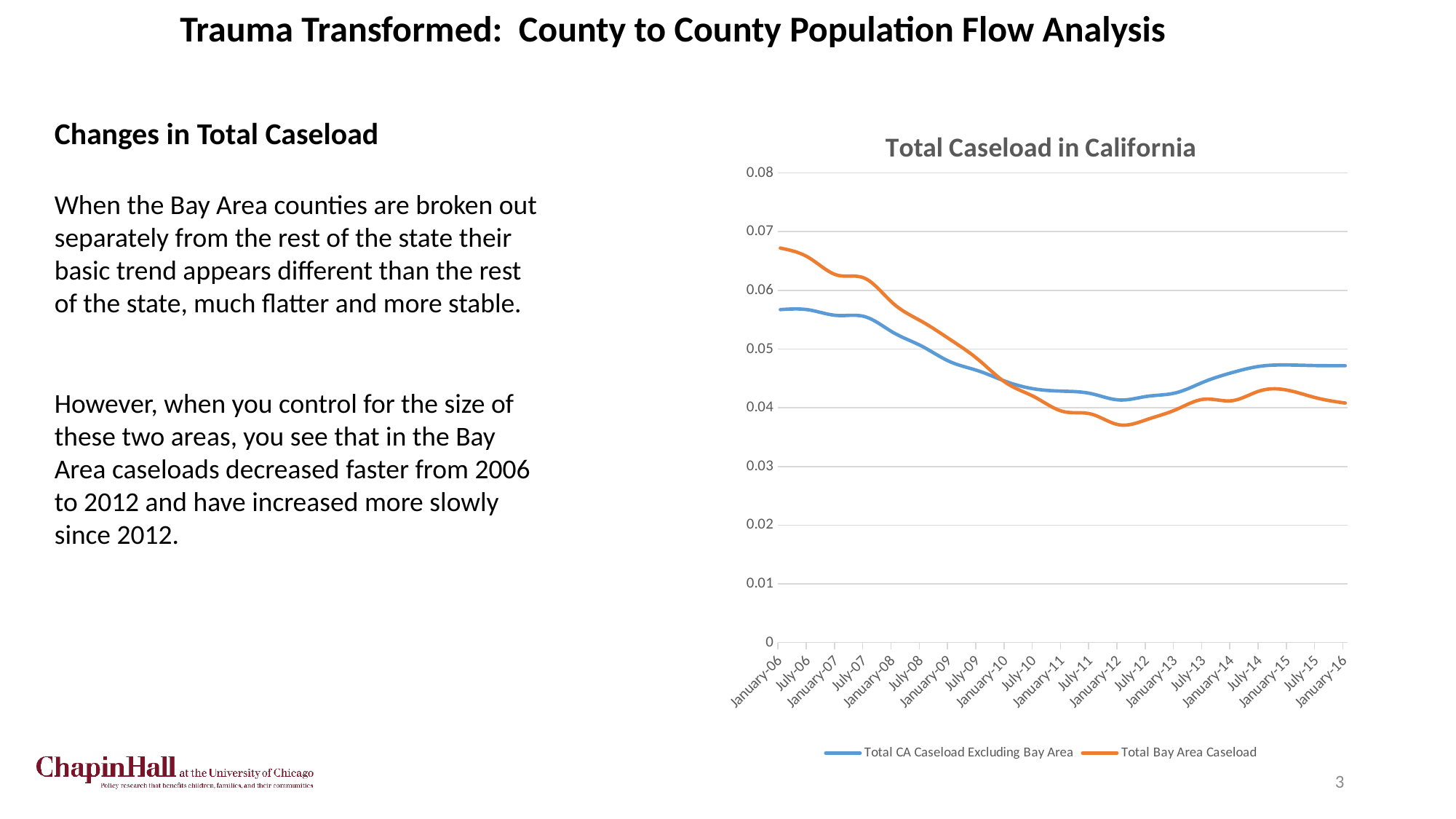
How many series does the legend list? 2 Is the Total CA Caseload Excluding Bay Area value at January-06 greater or less than 0.06? less Is the Total CA Caseload Excluding Bay Area value at January-16 greater or less than 0.04? greater Is the Total Bay Area Caseload value at January-12 greater or less than 0.04? less At January-16, which series has the higher value: Total CA Caseload Excluding Bay Area or Total Bay Area Caseload? Total CA Caseload Excluding Bay Area How many dates are labelled on the x axis? 21 What is the title of the chart? Total Caseload in California Does the Total Bay Area Caseload line rise or fall from January-06 to January-12? fall What kind of chart is shown on the slide? line chart Which series is drawn in orange? Total Bay Area Caseload At January-06, which series has the higher value: Total CA Caseload Excluding Bay Area or Total Bay Area Caseload? Total Bay Area Caseload